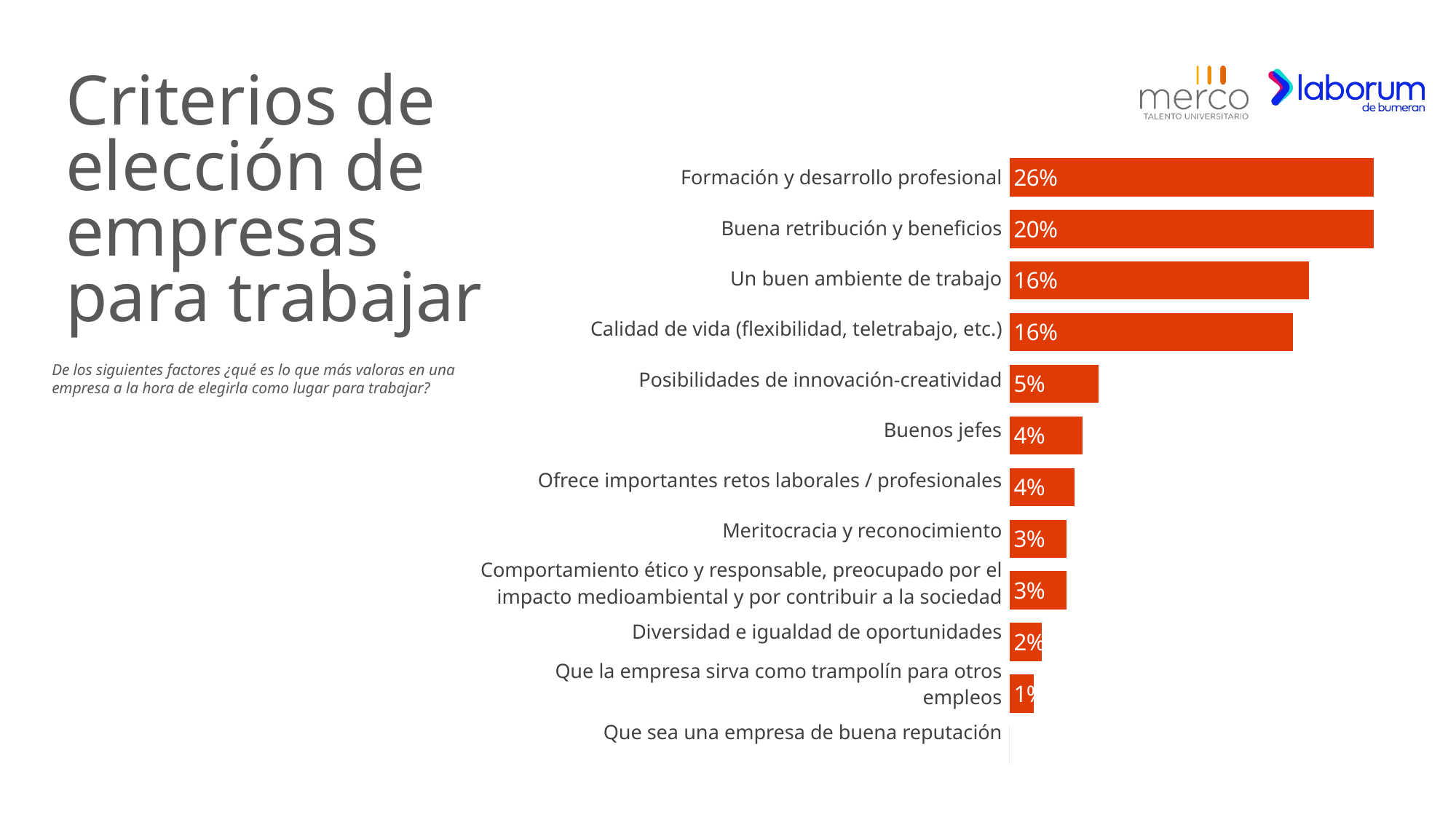
What is the value for 'Buena retribución y beneficios'? 20% What is the value for 'Meritocracia y reconocimiento'? 3% Which is larger: 'Un buen ambiente de trabajo' or 'Buenos jefes'? Un buen ambiente de trabajo Which category has the lowest value? Que sea una empresa de buena reputación What is the value for 'Formación y desarrollo profesional'? 26% What colour are the bars in the chart? Orange-red What is the difference between 'Formación y desarrollo profesional' and 'Buena retribución y beneficios'? 6% What is the value for 'Diversidad e igualdad de oportunidades'? 2% How many categories are shown in the chart? 12 What is the value for 'Posibilidades de innovación-creatividad'? 5% Which category has the highest value? Formación y desarrollo profesional What type of chart is shown on the slide? Bar chart